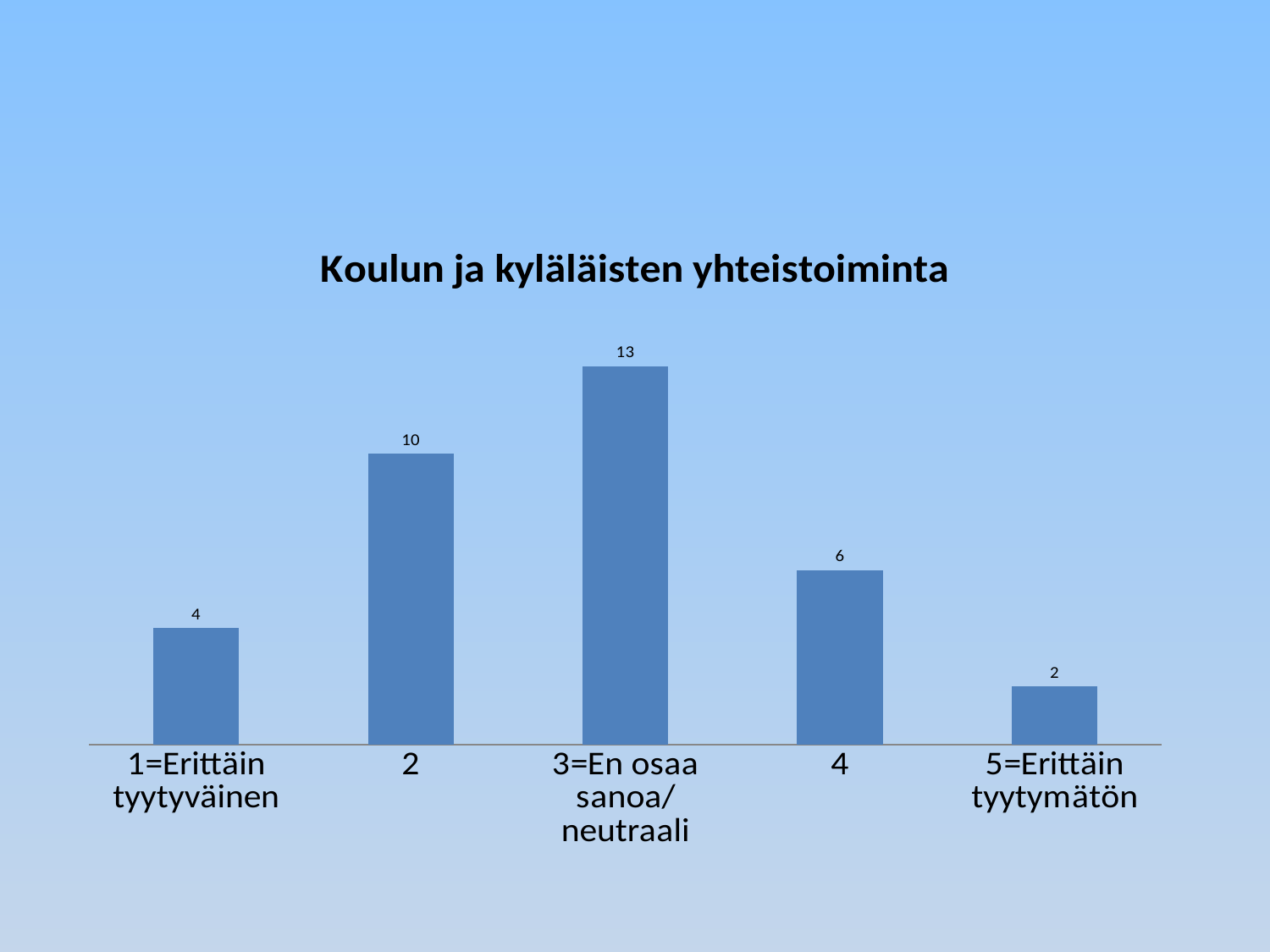
What is the total of all the values shown in the chart? 35 Which category has the lowest value? 5=Erittäin tyytymätön Which is larger, the value for "1=Erittäin tyytyväinen" or the value for "5=Erittäin tyytymätön"? 1=Erittäin tyytyväinen What is the title of the chart? Koulun ja kyläläisten yhteistoiminta Which category has the highest value? 3=En osaa sanoa/ neutraali How many categories are shown on the x axis? 5 What is the value for the category "3=En osaa sanoa/ neutraali"? 13 What is the difference between the values for category "2" and category "4"? 4 What is the value for the category "5=Erittäin tyytymätön"? 2 What is the value for category "4"? 6 What kind of chart is shown on the slide? Bar chart What is the value for the category "1=Erittäin tyytyväinen"? 4